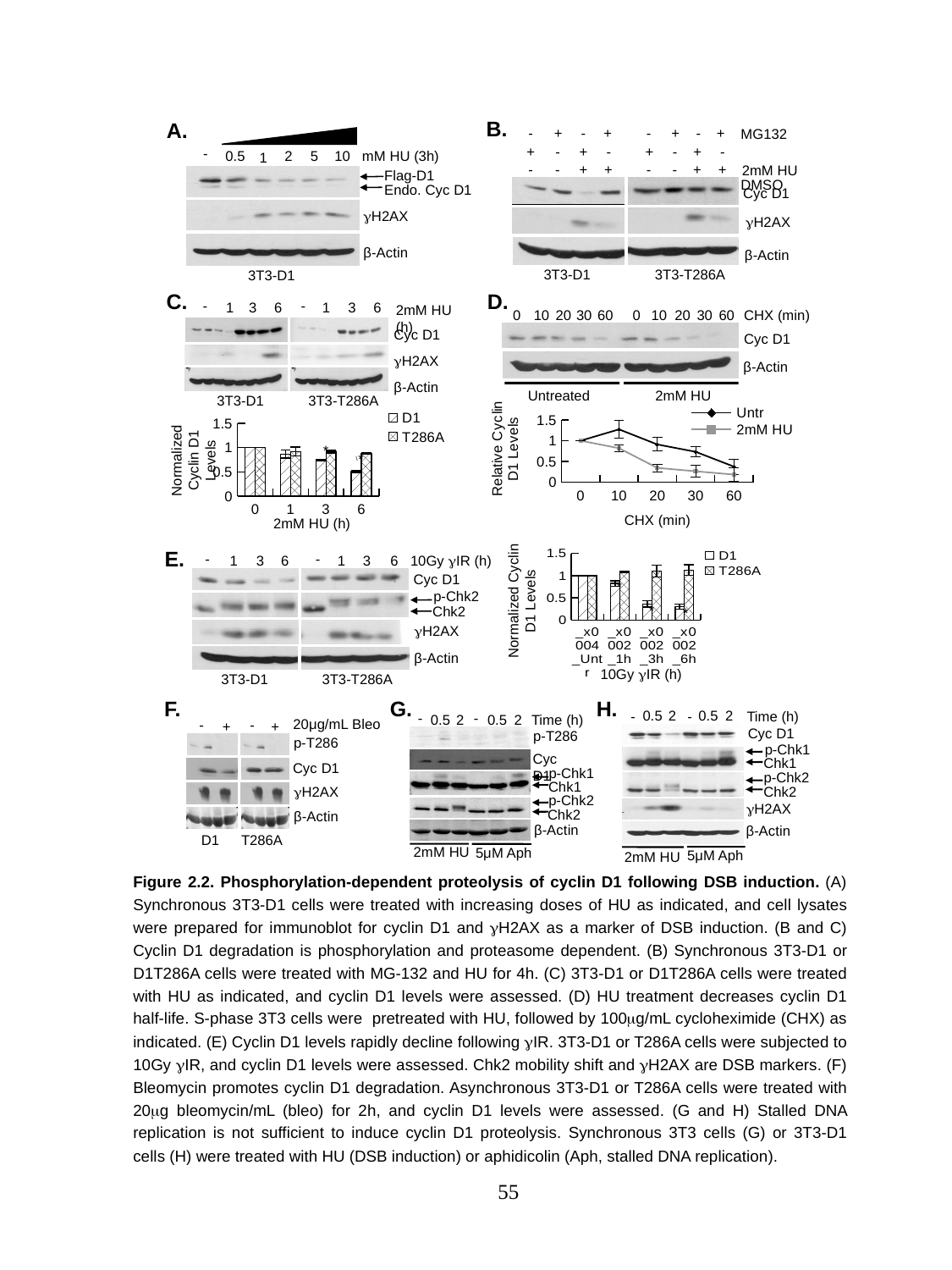
In the panel C bar chart, how many HU time categories are shown on the x axis? 4 What kind of chart is shown in panel D (Relative Cyclin D1 Levels vs CHX (min))? line chart In the panel D chart, which series has the higher value at 20 min CHX, Untr or 2mM HU? Untr In the panel D chart, does the 2mM HU series rise or fall as CHX time increases from 0 to 60 min? fall In the panel E bar chart, which series has the larger value at 3h of 10Gy γIR, D1 or T286A? T286A In the panel D chart, is the 2mM HU value at 20 min CHX greater or less than 0.5? less In the panel D line chart (Relative Cyclin D1 Levels vs CHX), how many series does the legend list? 2 In the panel D chart, how many CHX time points are plotted along the x axis? 5 What kind of chart is shown in panel C (Normalized Cyclin D1 Levels vs 2mM HU (h))? bar chart In the panel E bar chart (Normalized Cyclin D1 Levels vs 10Gy γIR), is the D1 value at 6h greater or less than 0.5? less In the panel C bar chart, which series has the larger value at 6 h of 2mM HU, D1 or T286A? T286A In the panel D line chart, what are the two series named in the legend? Untr and 2mM HU